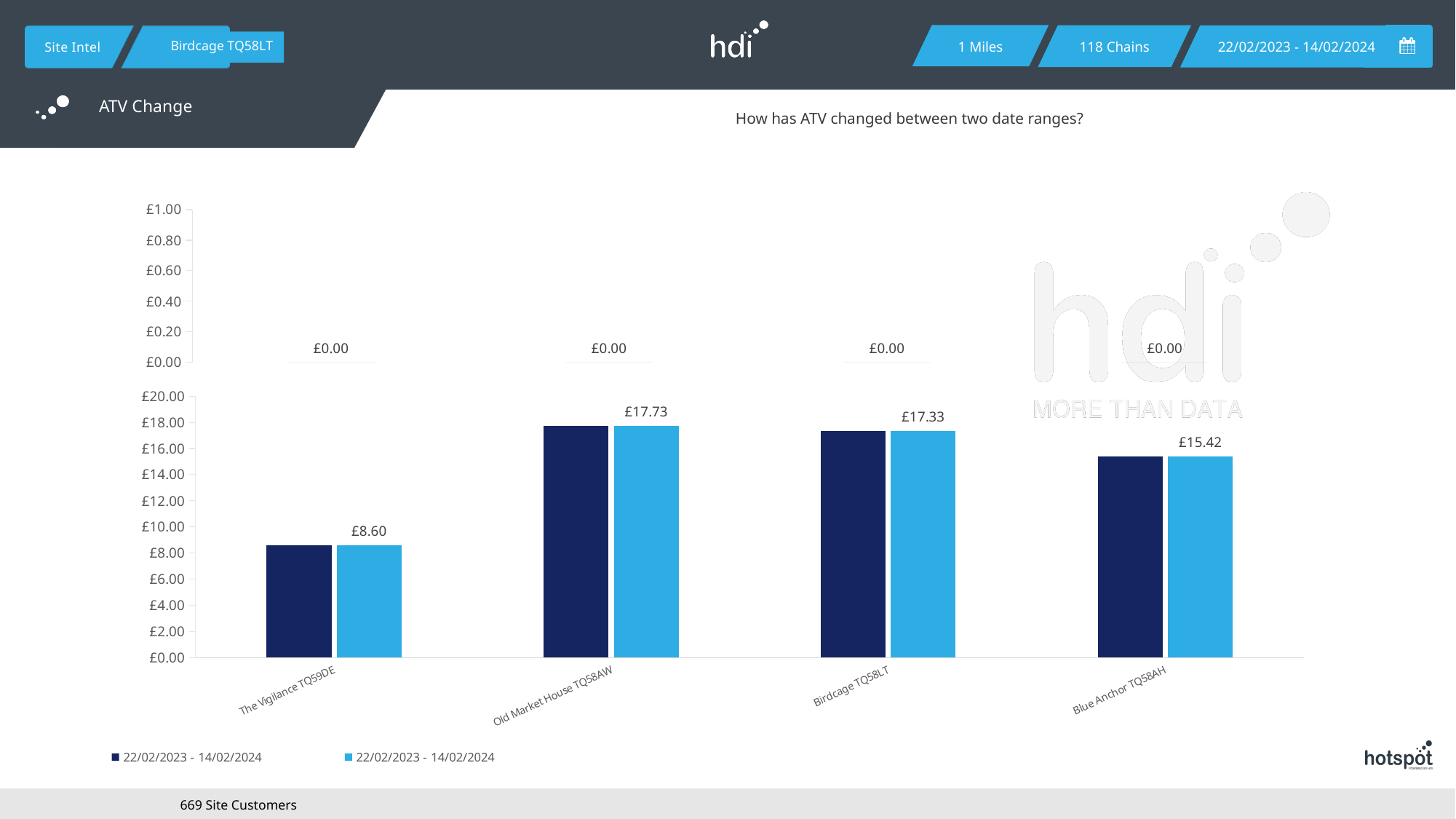
What is the labelled ATV value for Birdcage TQ58LT? £17.33 How many categories are shown on the x axis of the chart? 4 What kind of chart is shown on the slide? bar chart What ATV change value is labelled for each category in the upper panel of the chart? £0.00 How many series does the legend list? 2 Which has a larger labelled ATV value, Birdcage TQ58LT or Blue Anchor TQ58AH? Birdcage TQ58LT Which category has the highest labelled ATV value? Old Market House TQ58AW What is the labelled ATV value for The Vigilance TQ59DE? £8.60 What is the difference between the labelled ATV values for Old Market House TQ58AW and Blue Anchor TQ58AH? £2.31 Which category has the lowest labelled ATV value? The Vigilance TQ59DE What is the labelled ATV value for Blue Anchor TQ58AH? £15.42 What is the labelled ATV value for Old Market House TQ58AW? £17.73